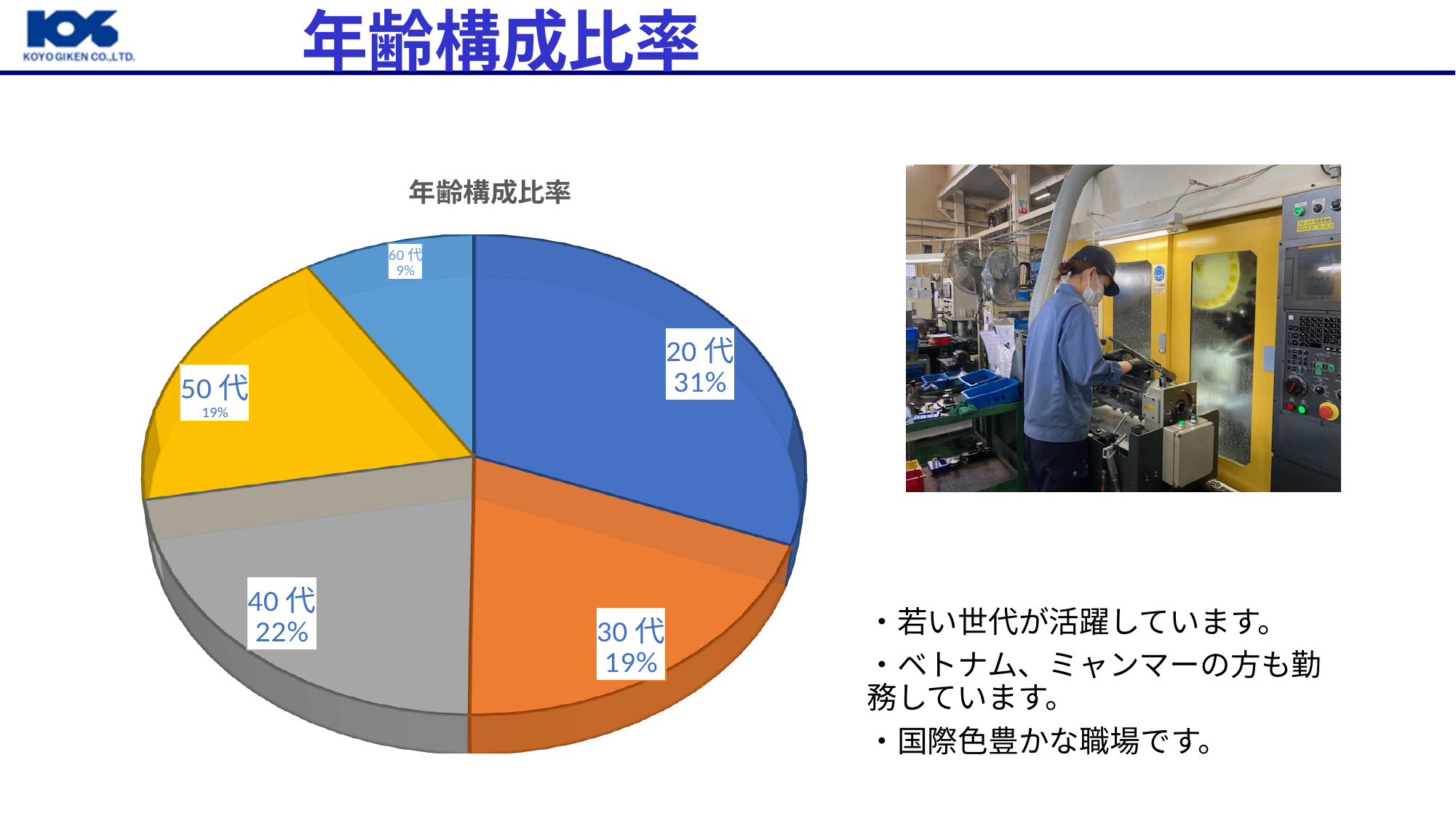
What is the value shown for 60代? 9% Which age group has the smallest share of the pie? 60代 Which age group has the largest share of the pie? 20代 What share of the pie does the 20代 slice represent? 31% What is the value shown for 40代? 22% What is the difference in percentage points between the 40代 and 60代 slices? 13 What is the title of the chart? 年齢構成比率 What colour is the 50代 slice? Yellow How many age groups are shown in the pie chart? 5 Which is larger, the share for 40代 or the share for 30代? 40代 What kind of chart is shown on the slide? Pie chart What is the difference in percentage points between the 20代 and 40代 slices? 9